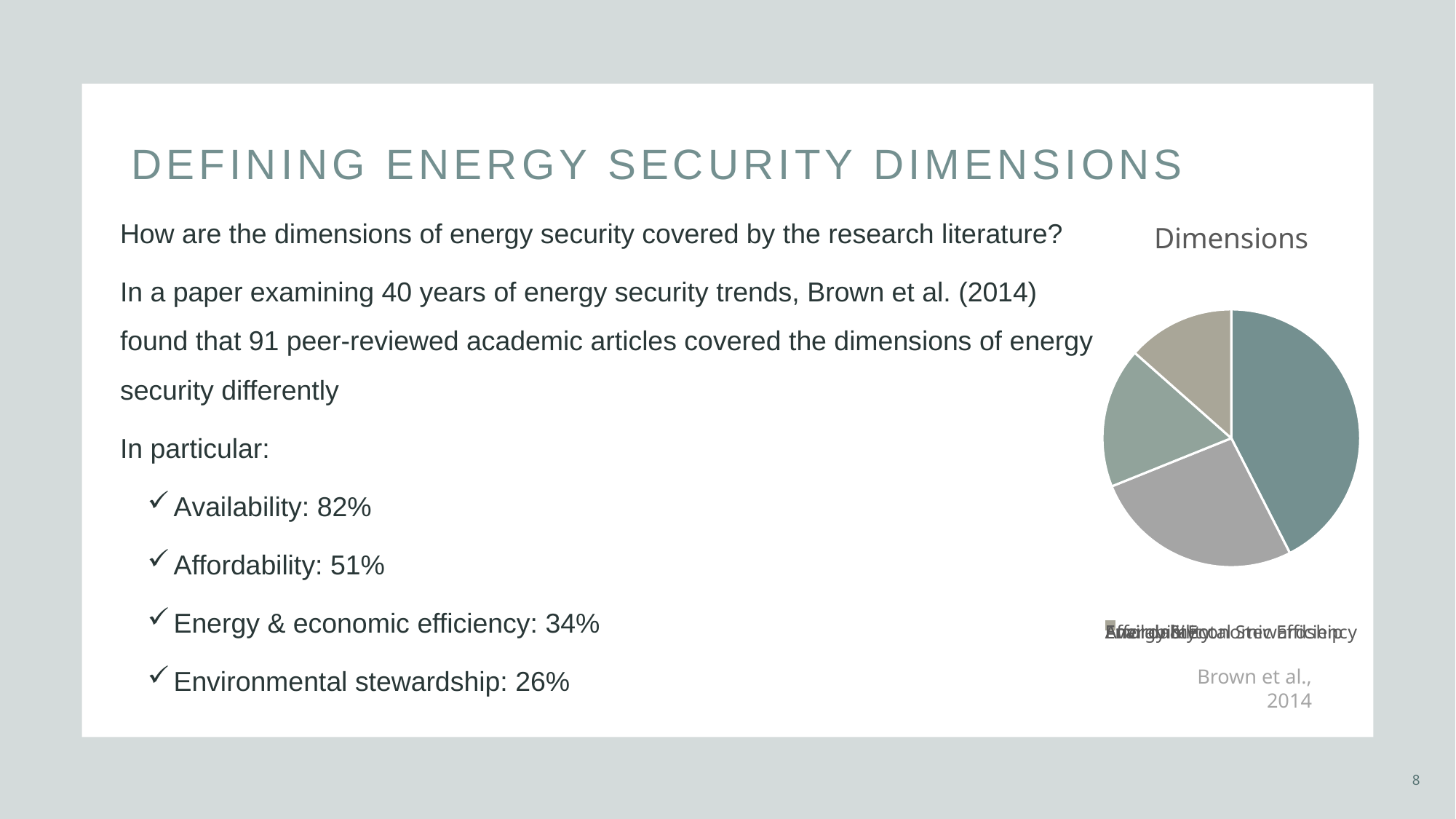
What kind of chart is shown on the slide? pie chart Is the dark teal slice of the pie chart larger or smaller than the grey slice? larger What is the title of the chart on the slide? Dimensions How many slices does the pie chart have? 4 Which colour is the largest slice of the pie chart? dark teal Does the largest slice of the pie chart take up more or less than half of the pie? less What source is cited beneath the pie chart? Brown et al., 2014